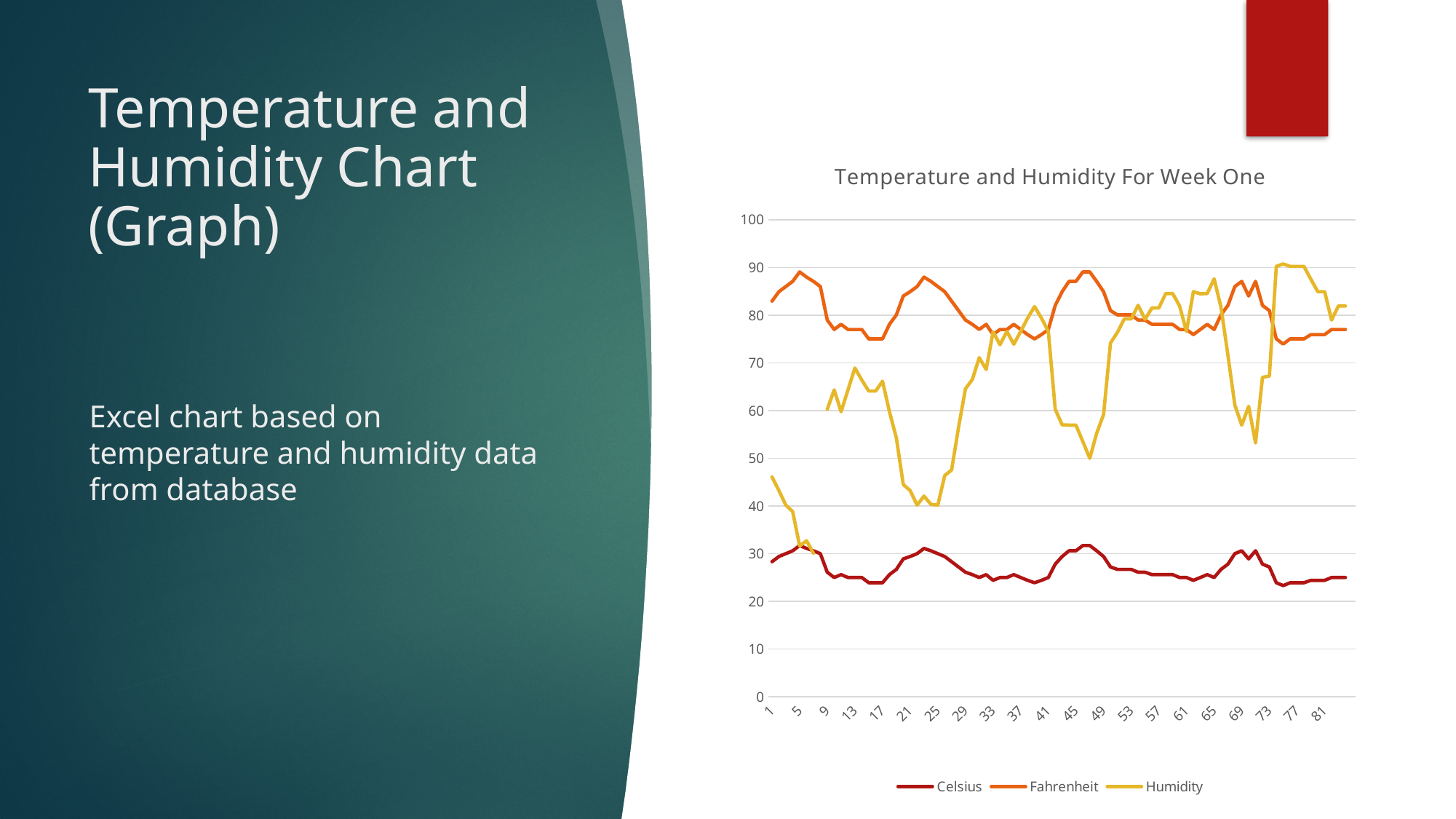
Is the Humidity value at point 9 greater or less than 50? greater Which series has the lowest values across the whole chart? Celsius What is the title of the chart? Temperature and Humidity For Week One What kind of chart is shown on the slide? line chart How many series does the legend list? 3 Does the Humidity line rise or fall between point 17 and point 21? fall Is the Humidity value at point 21 greater or less than 60? less Is the Fahrenheit value at point 5 greater or less than 80? greater Which series is drawn in yellow? Humidity At point 21, which is larger: the Humidity value or the Fahrenheit value? Fahrenheit